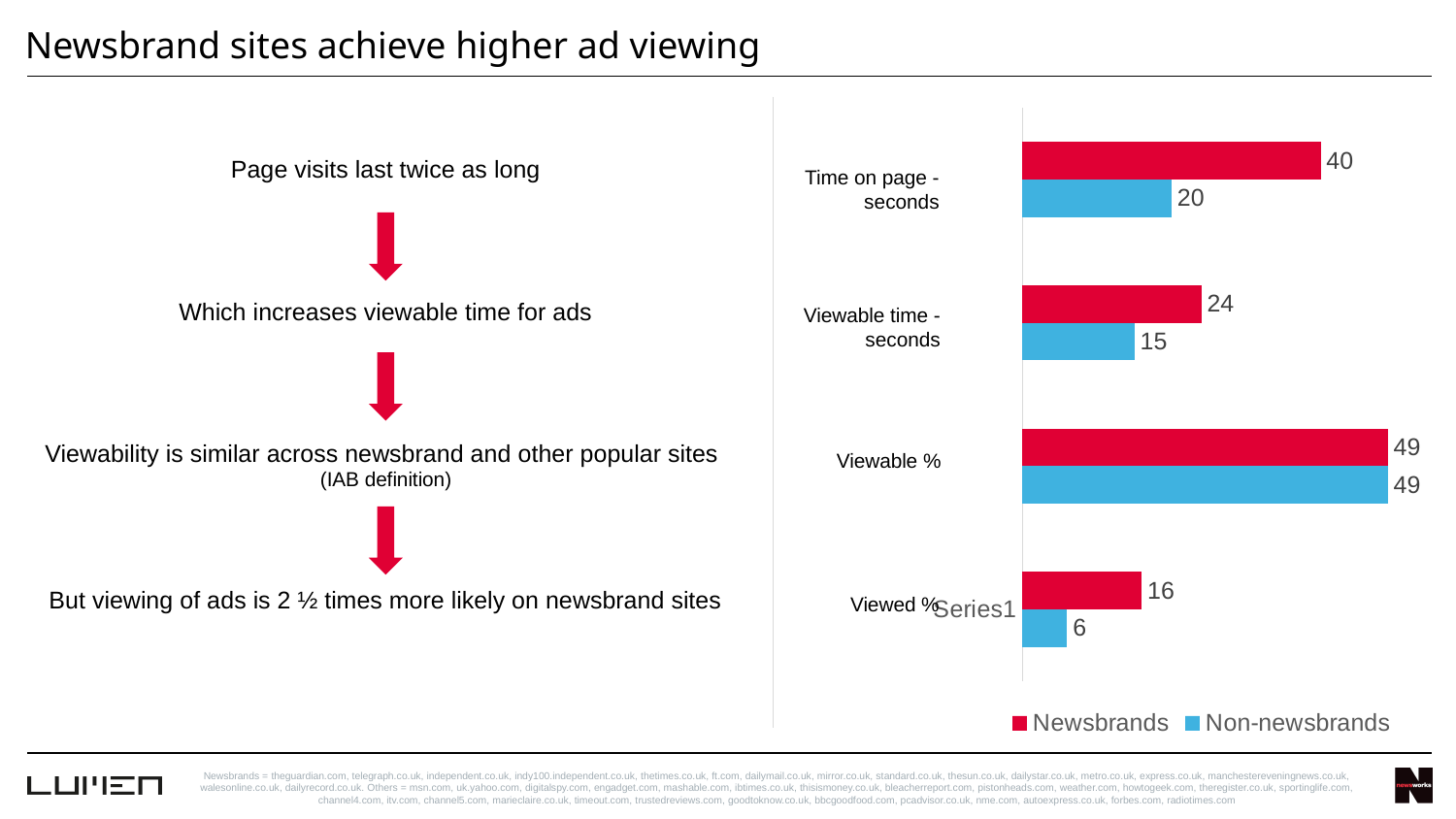
Which category has the highest Newsbrands value? Viewable % What is the value for Non-newsbrands for Viewable time - seconds? 15 How many series does the legend list? 2 Which category has the lowest Non-newsbrands value? Viewed % What is the difference between the Newsbrands and Non-newsbrands values for Time on page - seconds? 20 Which is larger for Viewable time - seconds: Newsbrands or Non-newsbrands? Newsbrands What is the value for Newsbrands for Viewable %? 49 What is the difference between the Newsbrands and Non-newsbrands values for Viewed %? 10 How many categories are shown on the chart? 4 What is the value for Non-newsbrands for Viewed %? 6 What is the value for Newsbrands for Time on page - seconds? 40 What kind of chart is shown on the slide? Bar chart